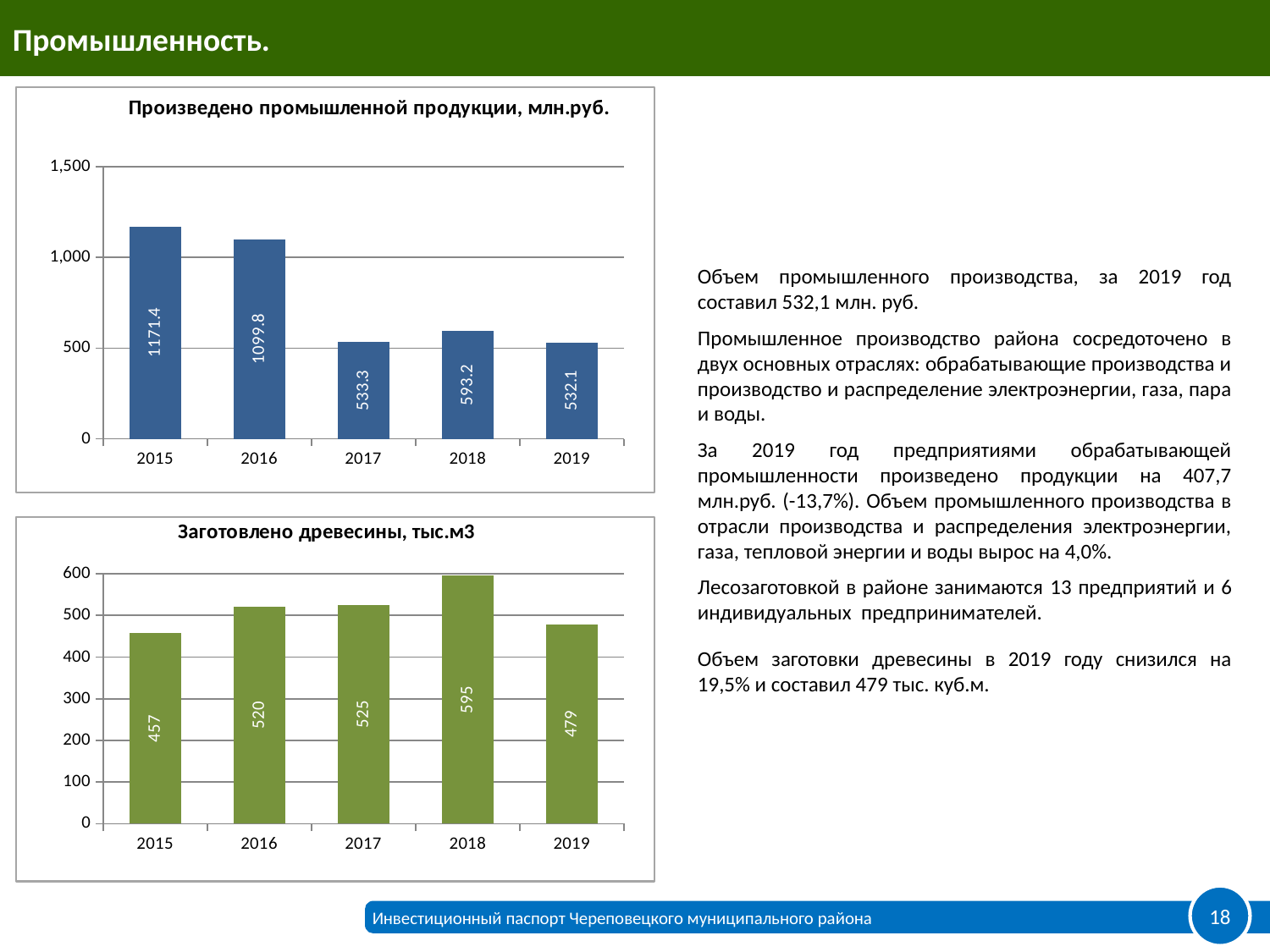
In the chart 'Заготовлено древесины, тыс.м3', which year has the lowest value? 2015 What kind of chart is 'Заготовлено древесины, тыс.м3'? bar chart In the chart 'Произведено промышленной продукции, млн.руб.', what is the difference between the values for 2015 and 2016? 71.6 In the chart 'Произведено промышленной продукции, млн.руб.', how many years are shown on the x axis? 5 In the chart 'Заготовлено древесины, тыс.м3', which is larger, the value for 2016 or the value for 2019? 2016 In the chart 'Произведено промышленной продукции, млн.руб.', what is the value for 2015? 1171.4 In the chart 'Заготовлено древесины, тыс.м3', which year has the highest value? 2018 In the chart 'Произведено промышленной продукции, млн.руб.', what colour are the bars? blue In the chart 'Заготовлено древесины, тыс.м3', what is the difference between the values for 2018 and 2019? 116 In the chart 'Произведено промышленной продукции, млн.руб.', is the value for 2018 greater or less than 1,000? less In the chart 'Заготовлено древесины, тыс.м3', what is the value for 2018? 595 In the chart 'Произведено промышленной продукции, млн.руб.', which year has the lowest value? 2019